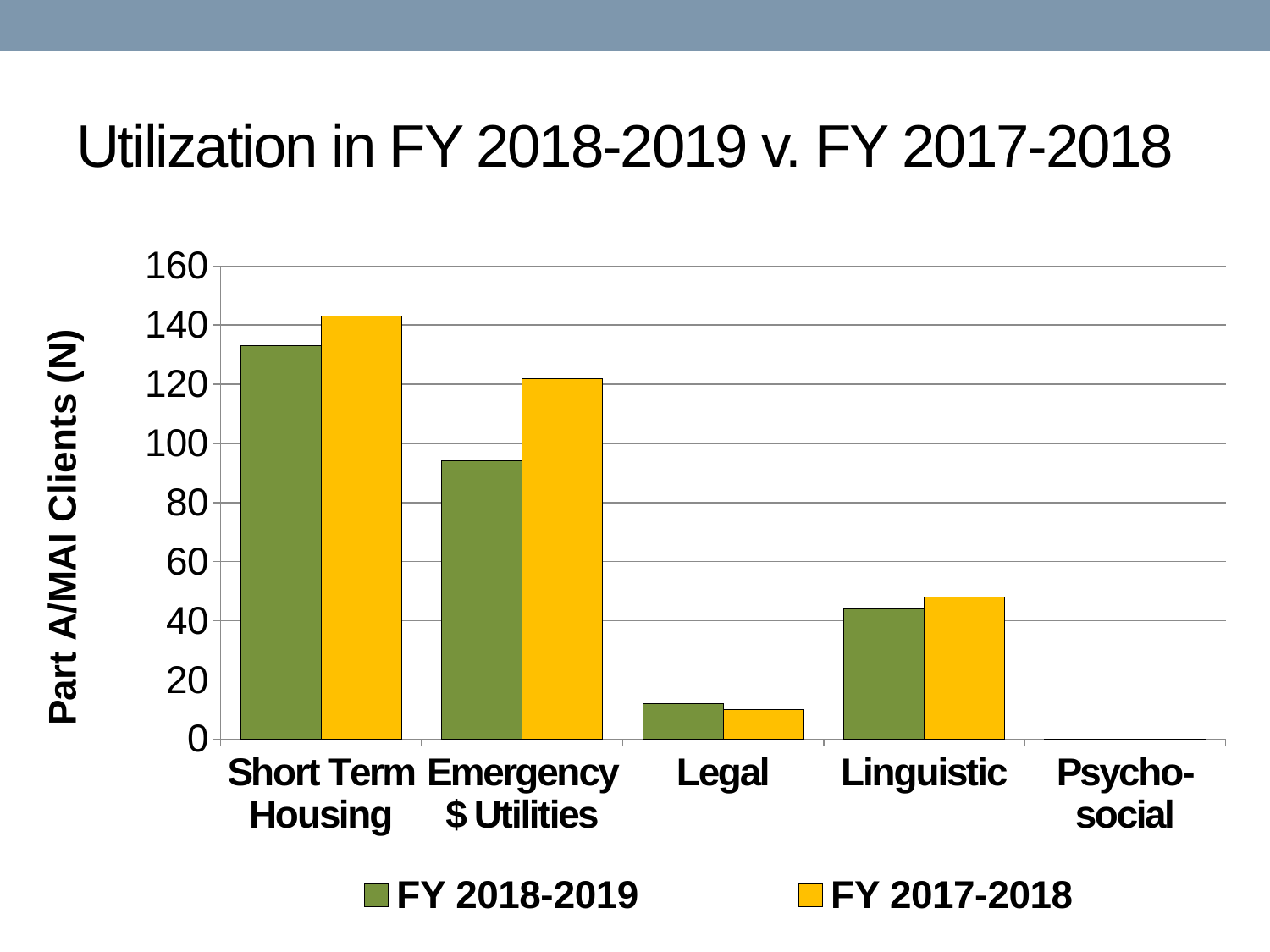
For Emergency $ Utilities, which series has the larger value, FY 2018-2019 or FY 2017-2018? FY 2017-2018 Which category has the highest FY 2017-2018 value? Short Term Housing Which category has the highest FY 2018-2019 value? Short Term Housing Is the FY 2018-2019 value for Short Term Housing greater or less than 120? greater What is the label on the vertical axis? Part A/MAI Clients (N) Which category has the lowest FY 2018-2019 value? Psycho-social Is the FY 2018-2019 value for Emergency $ Utilities greater or less than 100? less What kind of chart is shown on the slide? Bar chart For Short Term Housing, which series has the larger value, FY 2018-2019 or FY 2017-2018? FY 2017-2018 How many service categories are shown on the x axis? 5 Is the FY 2017-2018 value for Linguistic greater or less than 60? less How many series does the legend list? 2